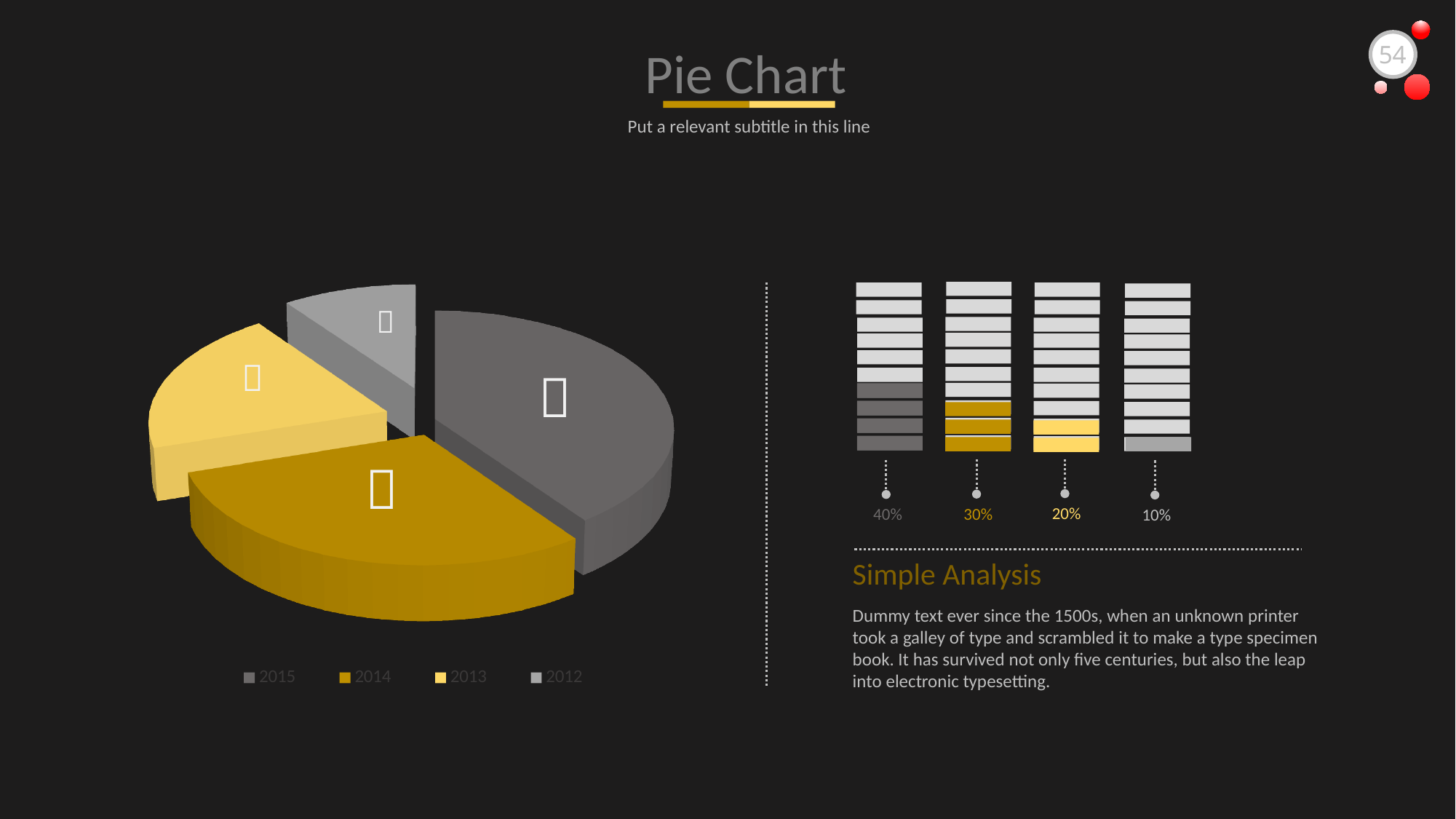
What is the title of the chart slide? Pie Chart Which category has the largest slice in the pie chart? 2015 In the pie chart, which slice is larger, 2014 or 2012? 2014 In the pie chart, which slice is larger, 2015 or 2013? 2015 In the pie chart, which slice is larger, 2014 or 2013? 2014 Which category has the smallest slice in the pie chart? 2012 How many entries does the pie chart's legend list? 4 What are the legend entries of the pie chart, in order from left to right? 2015, 2014, 2013, 2012 How many slices does the pie chart have? 4 What kind of chart is shown on the left of the slide? pie chart